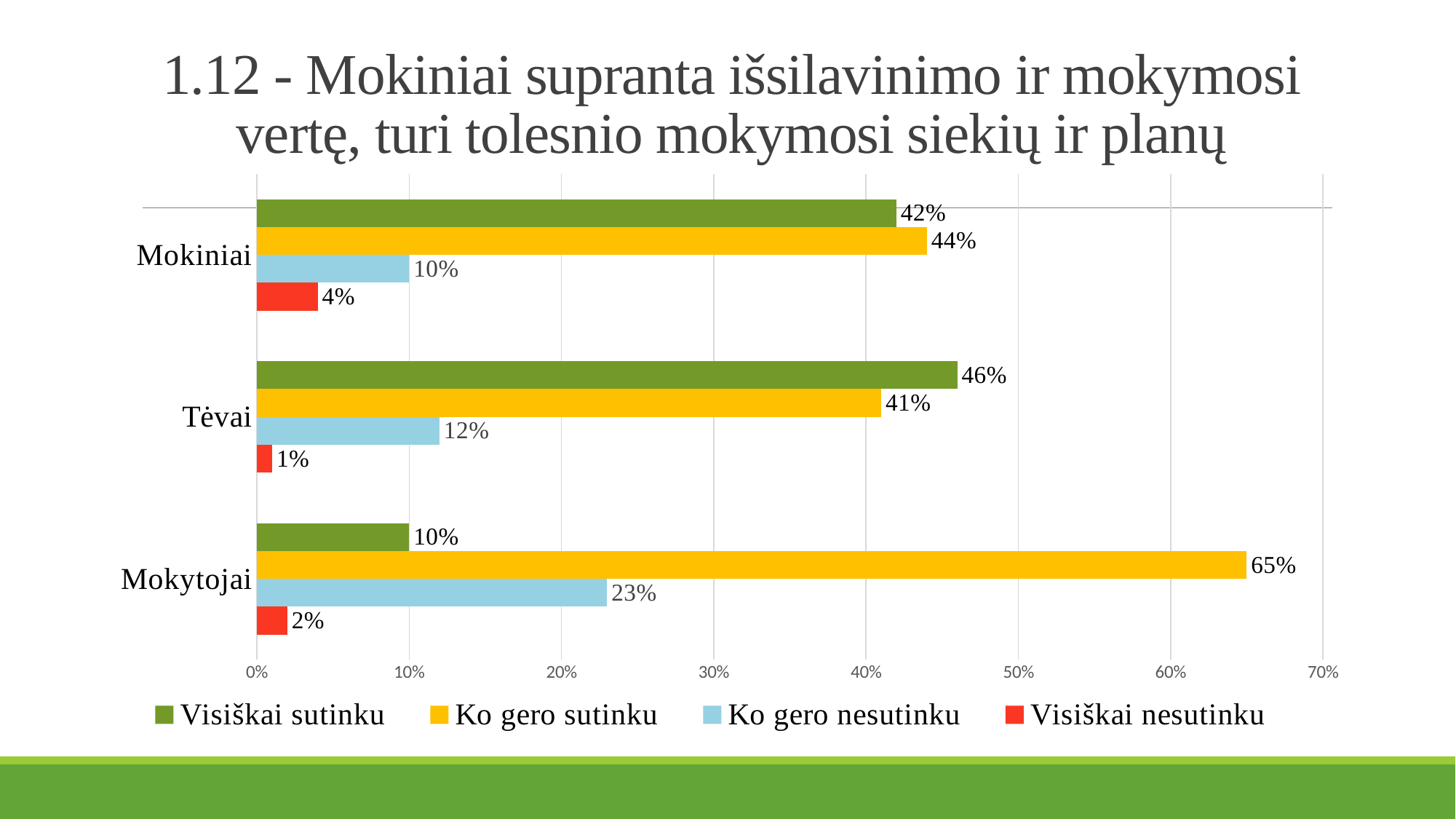
What is the value for "Visiškai sutinku" for Tėvai? 46% What is the value for "Visiškai nesutinku" for Tėvai? 1% Which category has the lowest value for "Visiškai sutinku"? Mokytojai What is the value for "Ko gero nesutinku" for Mokiniai? 10% What is the value for "Ko gero sutinku" for Mokytojai? 65% How many series does the legend list? 4 What colour represents the "Visiškai nesutinku" series? Red Which is larger for Mokiniai: "Visiškai sutinku" or "Ko gero sutinku"? Ko gero sutinku How many categories are shown on the vertical axis? 3 Which category has the highest value for "Ko gero sutinku"? Mokytojai What kind of chart is shown on the slide? Bar chart What is the difference between the "Ko gero sutinku" values for Mokytojai and Tėvai? 24%